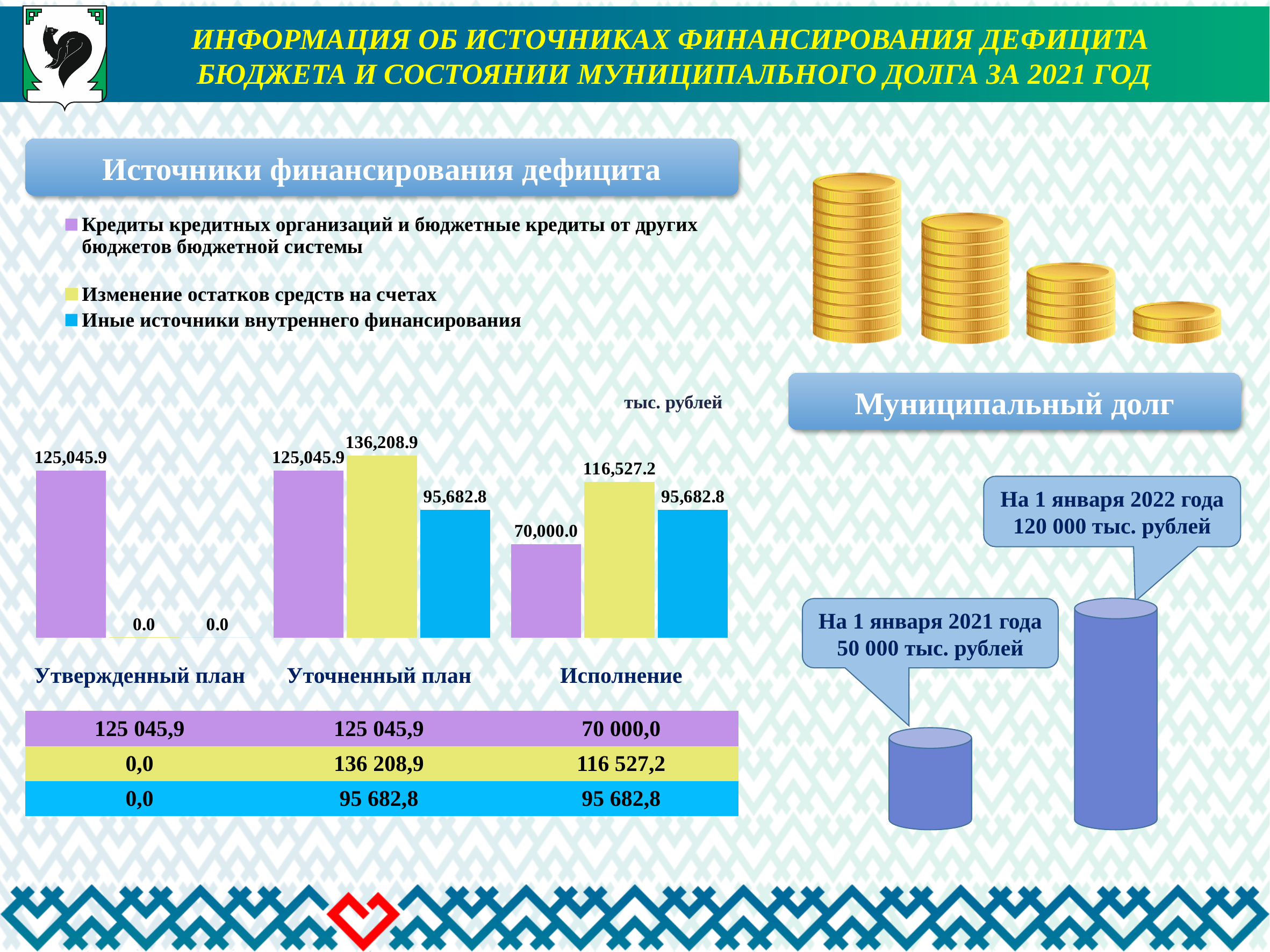
How many categories are shown on the x axis of the 'Источники финансирования дефицита' chart? 3 On the 'Источники финансирования дефицита' chart, what is the value of 'Изменение остатков средств на счетах' for 'Уточненный план'? 136,208.9 On the 'Источники финансирования дефицита' chart, what is the difference between 'Изменение остатков средств на счетах' for 'Уточненный план' and for 'Исполнение'? 19,681.7 On the 'Источники финансирования дефицита' chart, what is the difference between 'Кредиты кредитных организаций...' for 'Уточненный план' and for 'Исполнение'? 55,045.9 On the 'Источники финансирования дефицита' chart, which category has the highest value for 'Изменение остатков средств на счетах'? Уточненный план On the 'Источники финансирования дефицита' chart, what is the value of 'Кредиты кредитных организаций и бюджетные кредиты от других бюджетов бюджетной системы' for 'Исполнение'? 70,000.0 On the 'Источники финансирования дефицита' chart, which category has the lowest value for 'Кредиты кредитных организаций и бюджетные кредиты от других бюджетов бюджетной системы'? Исполнение On the 'Источники финансирования дефицита' chart, for 'Исполнение', which is larger: 'Изменение остатков средств на счетах' or 'Иные источники внутреннего финансирования'? Изменение остатков средств на счетах What type of chart is the 'Источники финансирования дефицита' chart? Bar chart On the 'Источники финансирования дефицита' chart, what is the value of 'Иные источники внутреннего финансирования' for 'Утвержденный план'? 0.0 How many series does the legend of the 'Источники финансирования дефицита' chart list? 3 In the 'Муниципальный долг' graphic, what is the difference between the debt on 1 January 2022 and on 1 January 2021? 70 000 тыс. рублей